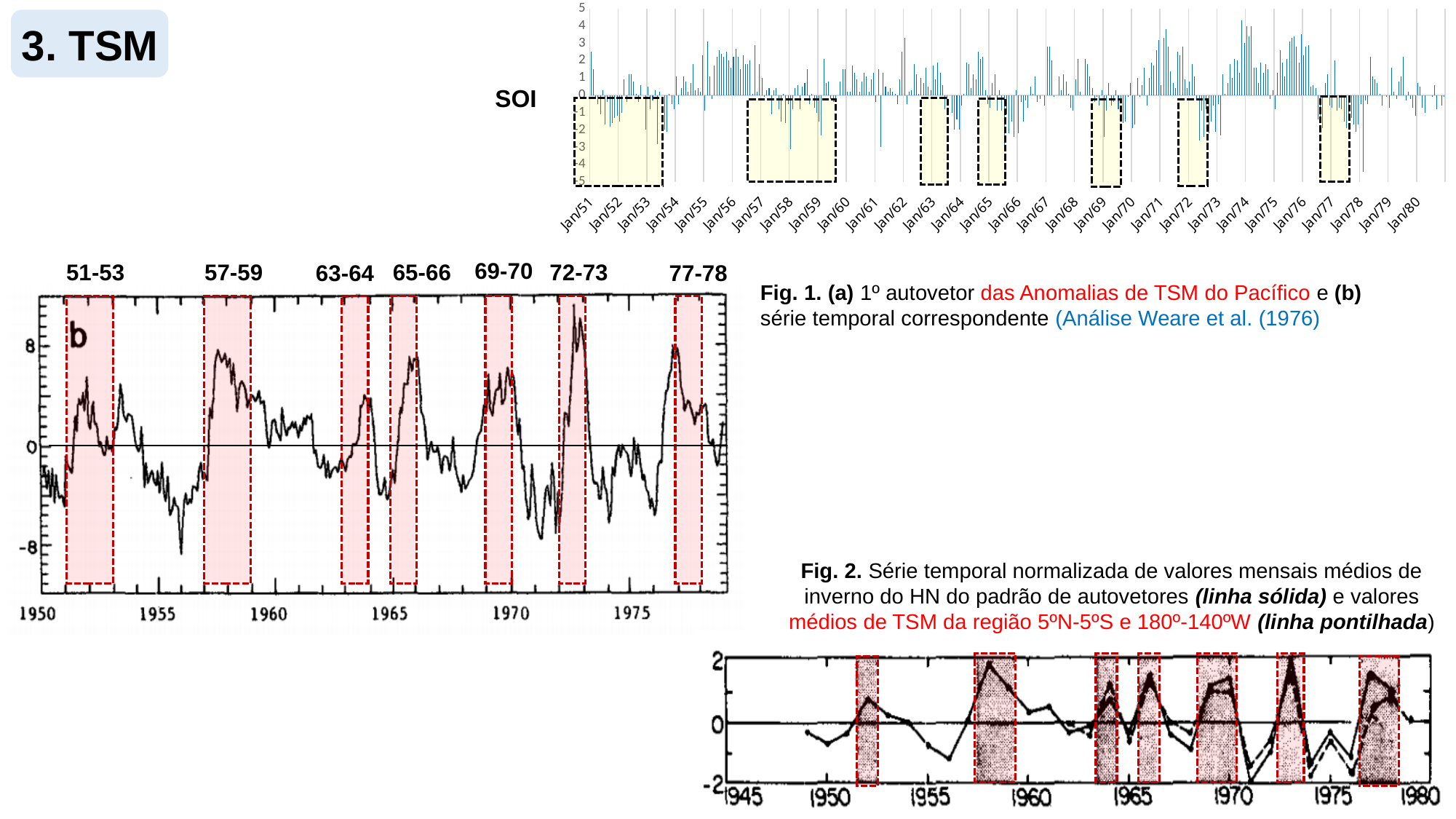
On the Fig. 1 (b) chart at the bottom left, what is the label of the first highlighted period? 51-53 On the Fig. 1 (b) chart at the bottom left, is the peak value in the 57-59 period greater or less than 0? greater What is the highest y-axis tick value shown on the Fig. 2 chart at the bottom right? 2 What kind of chart is the SOI chart at the top right of the slide? bar chart On the Fig. 2 chart at the bottom right, is the peak value around 1958 greater or less than 0? greater On the Fig. 1 (b) chart at the bottom left, what is the label of the last highlighted period? 77-78 What kind of chart is Fig. 1 (b) at the bottom left of the slide? line chart On the Fig. 1 (b) chart at the bottom left, is the value around 1956 greater or less than 0? less What is the first x-axis label on the SOI bar chart at the top right? Jan/51 How many highlighted (dashed-box) periods are marked on the Fig. 1 (b) chart at the bottom left? 7 How many dashed highlight boxes are drawn on the SOI bar chart at the top right? 7